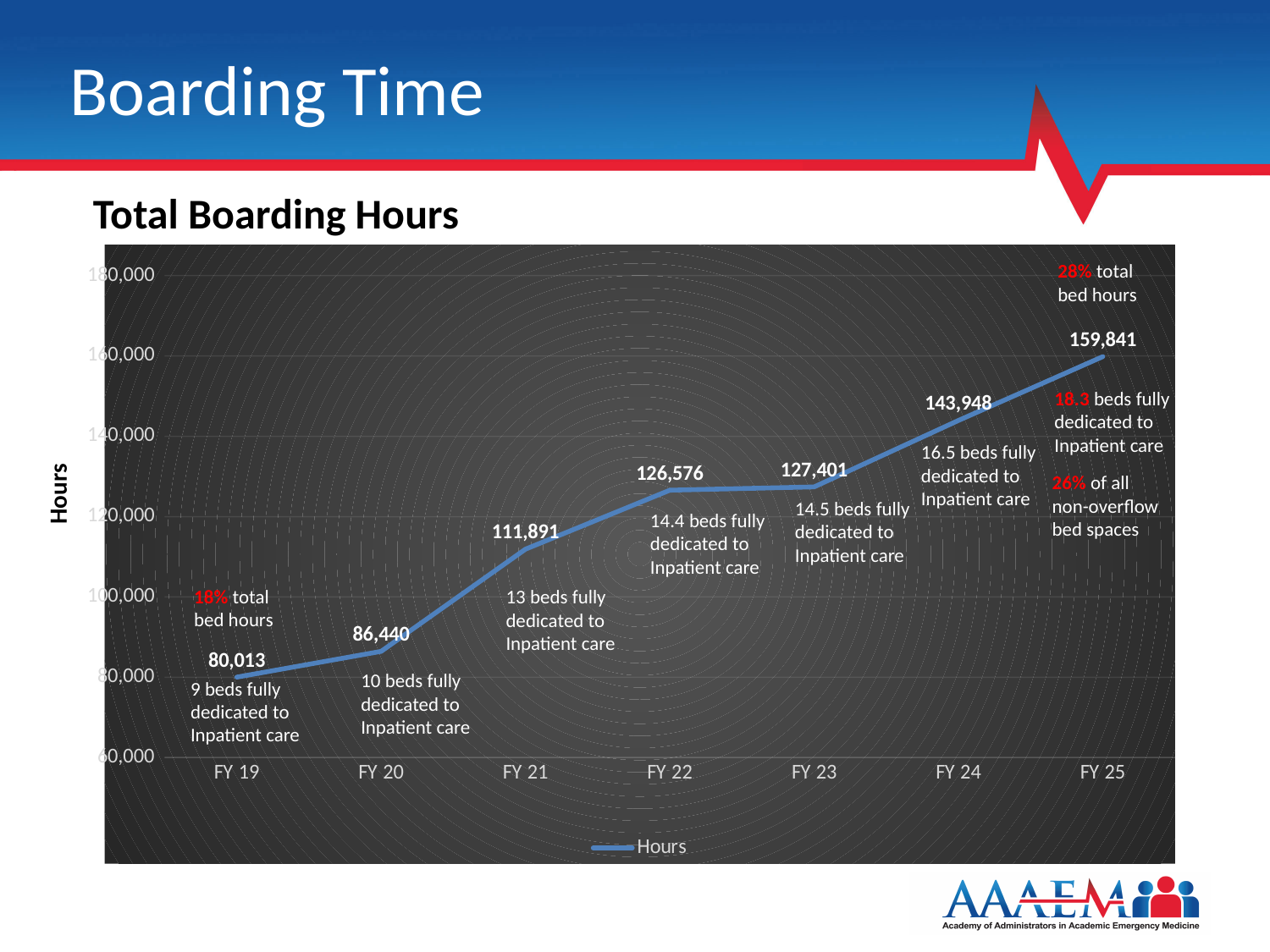
Which fiscal year has the lowest total boarding hours? FY 19 How many fiscal years are plotted on the x axis? 7 Which has more boarding hours, FY 21 or FY 24? FY 24 What is the value for FY 22 in the Total Boarding Hours chart? 126,576 Which fiscal year has the highest total boarding hours? FY 25 What is the value for FY 19 in the Total Boarding Hours chart? 80,013 What is the difference in boarding hours between FY 25 and FY 19? 79,828 What is the difference in boarding hours between FY 24 and FY 23? 16,547 What is the value for FY 25 in the Total Boarding Hours chart? 159,841 Is the value for FY 20 greater or less than 100,000? less Do the boarding hours rise or fall from FY 19 to FY 25? rise What type of chart is shown on the slide? line chart